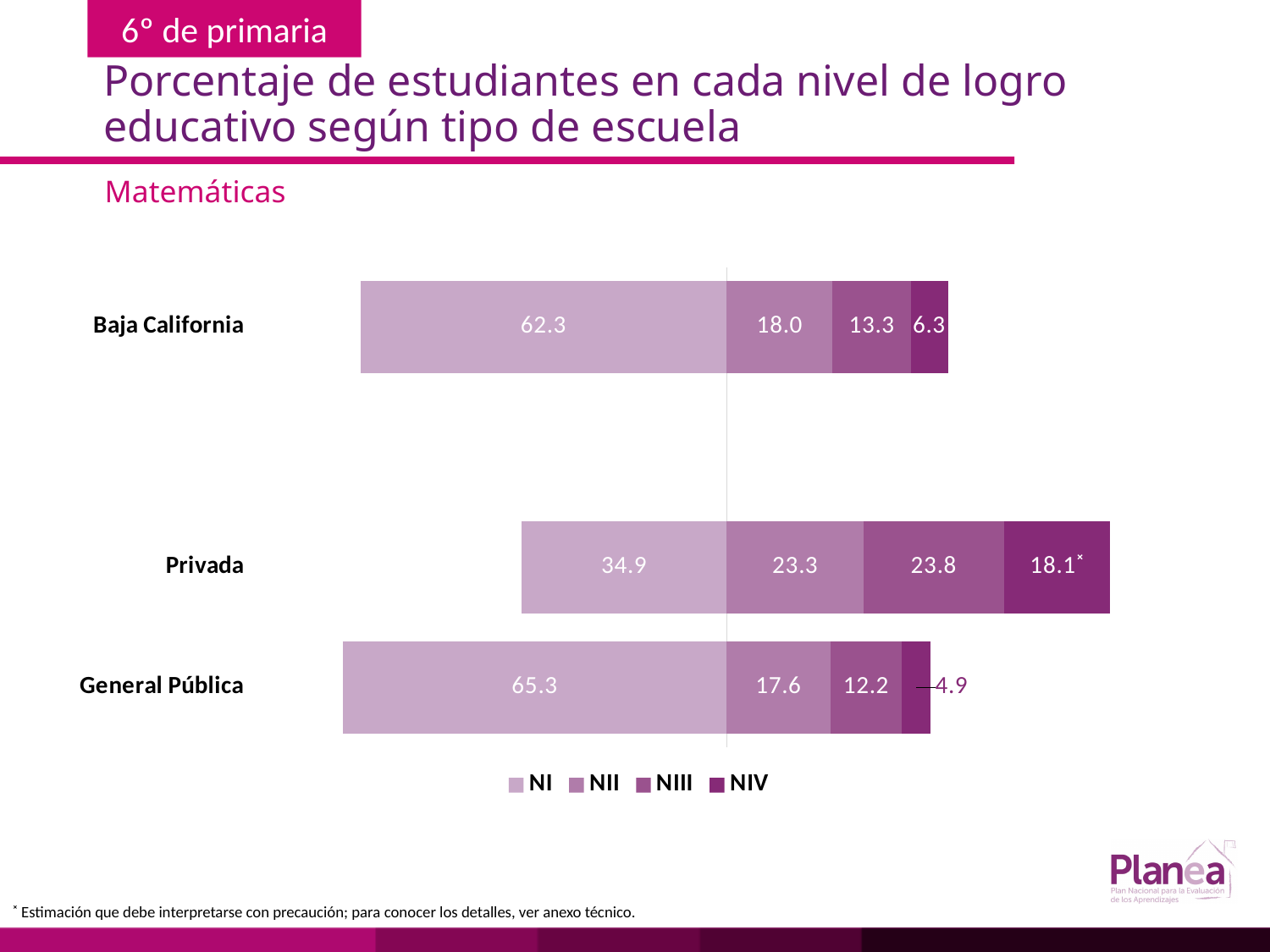
How many series does the legend list? 4 What kind of chart is shown on the slide? Stacked bar chart Which school type has the lowest NIV percentage? General Pública What is the total of the stacked bar for General Pública? 100.0 Which subject is the chart about, according to the subtitle? Matemáticas Which school type has the highest NI percentage? General Pública Which is larger, the NII value for Privada or the NII value for Baja California? Privada What is the NIV value for Privada schools? 18.1 How many school categories are shown in the chart? 3 What is the NIII value for General Pública schools? 12.2 What percentage of students in Baja California are at level NI? 62.3 What is the difference between the NI values for General Pública and Privada? 30.4